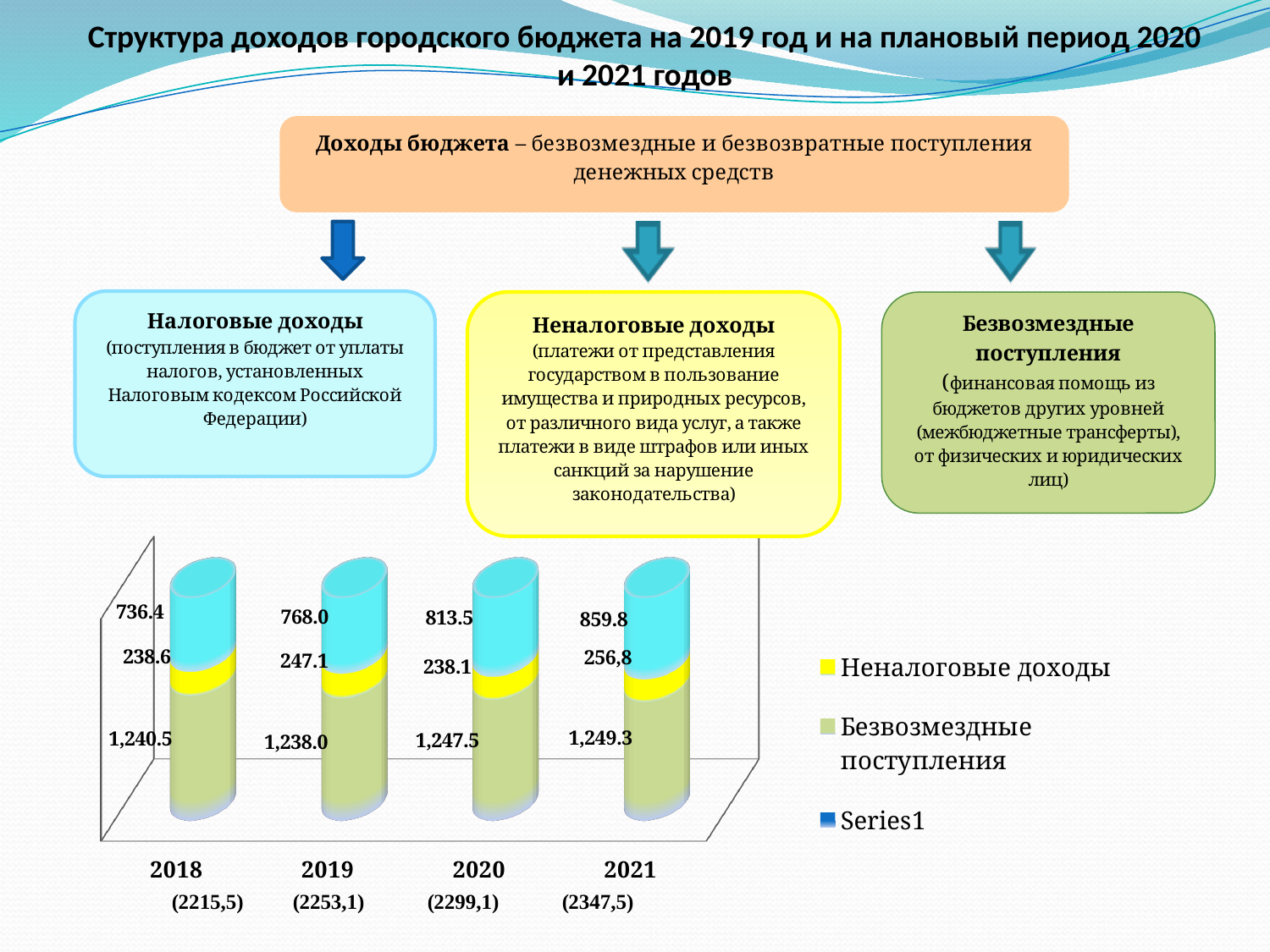
What is the value of Безвозмездные поступления for 2020? 1,247.5 Which year has the highest value for the top (cyan) segment? 2021 What is the value labelled on the top (cyan) segment of the 2021 bar? 859.8 What is the total shown for the 2018 bar? 2215,5 What kind of chart is shown on the slide? Stacked bar chart What is the value of Неналоговые доходы for 2019? 247.1 Do the values of the top (cyan) segment rise or fall from 2018 to 2021? Rise How many series does the legend list? 3 What is the difference between the top (cyan) segment values for 2021 and 2018? 123.4 How many years are shown on the x axis of the chart? 4 Which year has the lowest value for Неналоговые доходы? 2020 Which is larger: Неналоговые доходы in 2021 or in 2019? 2021